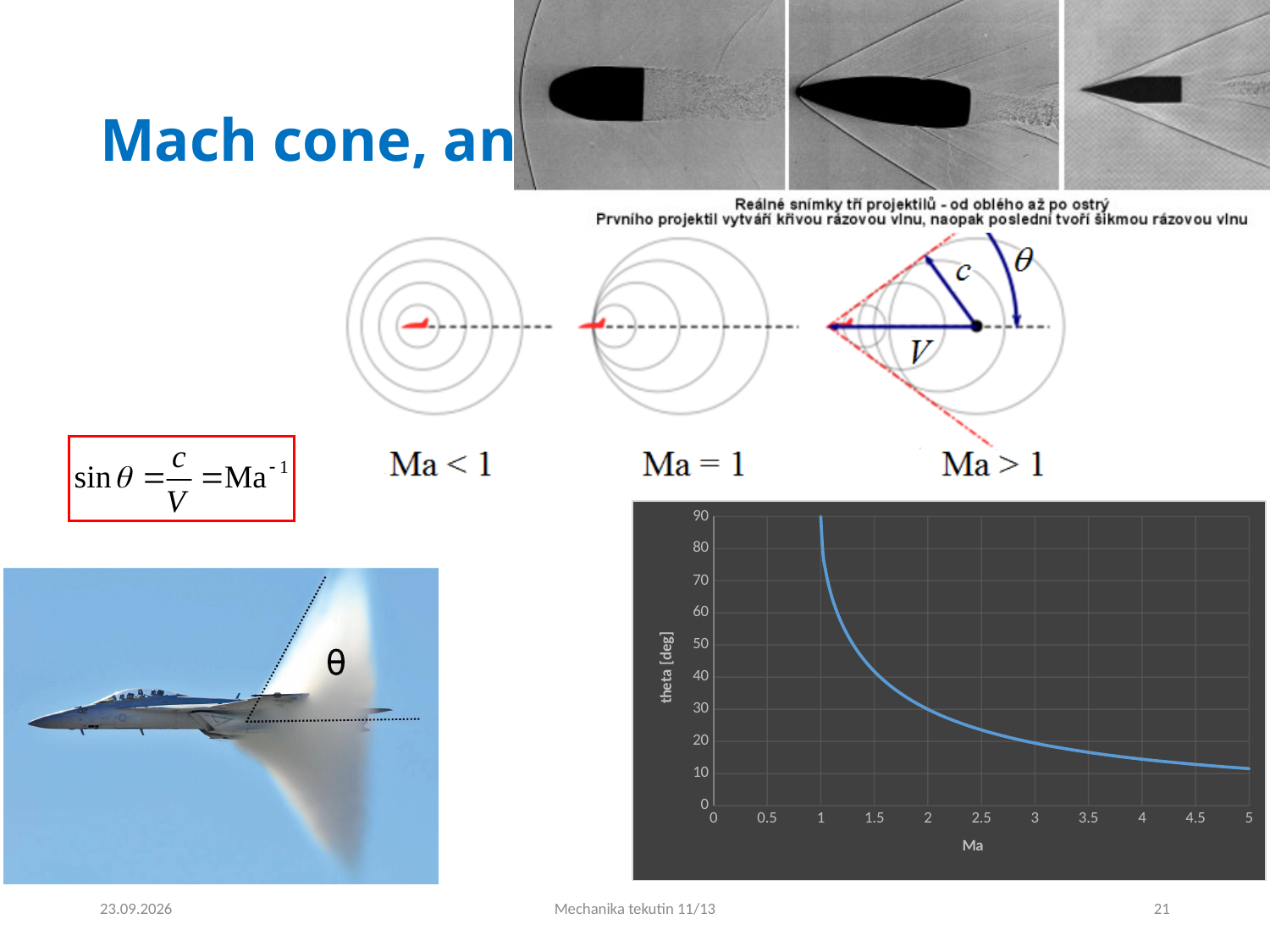
Is the value of theta at Ma = 4 greater or less than 20? less Does theta rise or fall as Ma increases along the x axis? fall What is the label of the horizontal axis of the chart? Ma What is the label of the vertical axis of the chart? theta [deg] Is the value of theta at Ma = 2.5 greater or less than 20? greater Which has the larger theta value, Ma = 1.5 or Ma = 3? Ma = 1.5 What is the value of theta at Ma = 1, where the curve starts? 90 Is the value of theta at Ma = 1.5 greater or less than 50? less At which Ma value on the chart is theta highest? 1 What kind of chart is shown at the bottom right of the slide? line chart